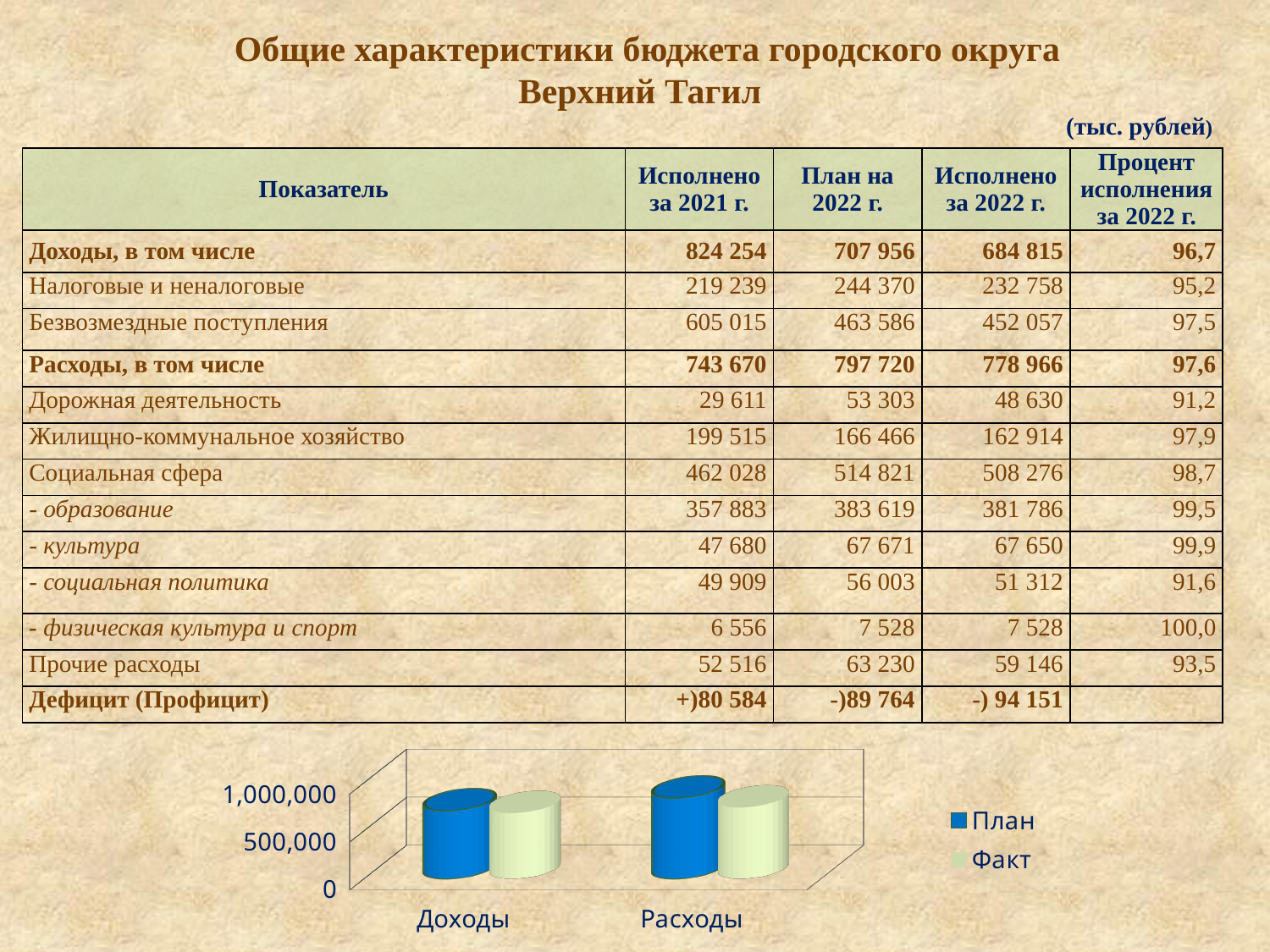
How many categories are shown on the x axis of the chart? 2 What are the two series named in the chart legend? План and Факт What are the categories shown on the x axis of the chart? Доходы and Расходы What kind of chart is shown at the bottom of the slide? bar chart Is the План value for Расходы greater or less than 1,000,000? less For the Факт series, which category has the taller bar, Доходы or Расходы? Расходы How many series does the chart legend list? 2 Is the План value for Доходы greater or less than 500,000? greater Which colour represents the План series in the chart? blue Is the Факт value for Расходы greater or less than 1,000,000? less For the План series, which category has the taller bar, Доходы or Расходы? Расходы